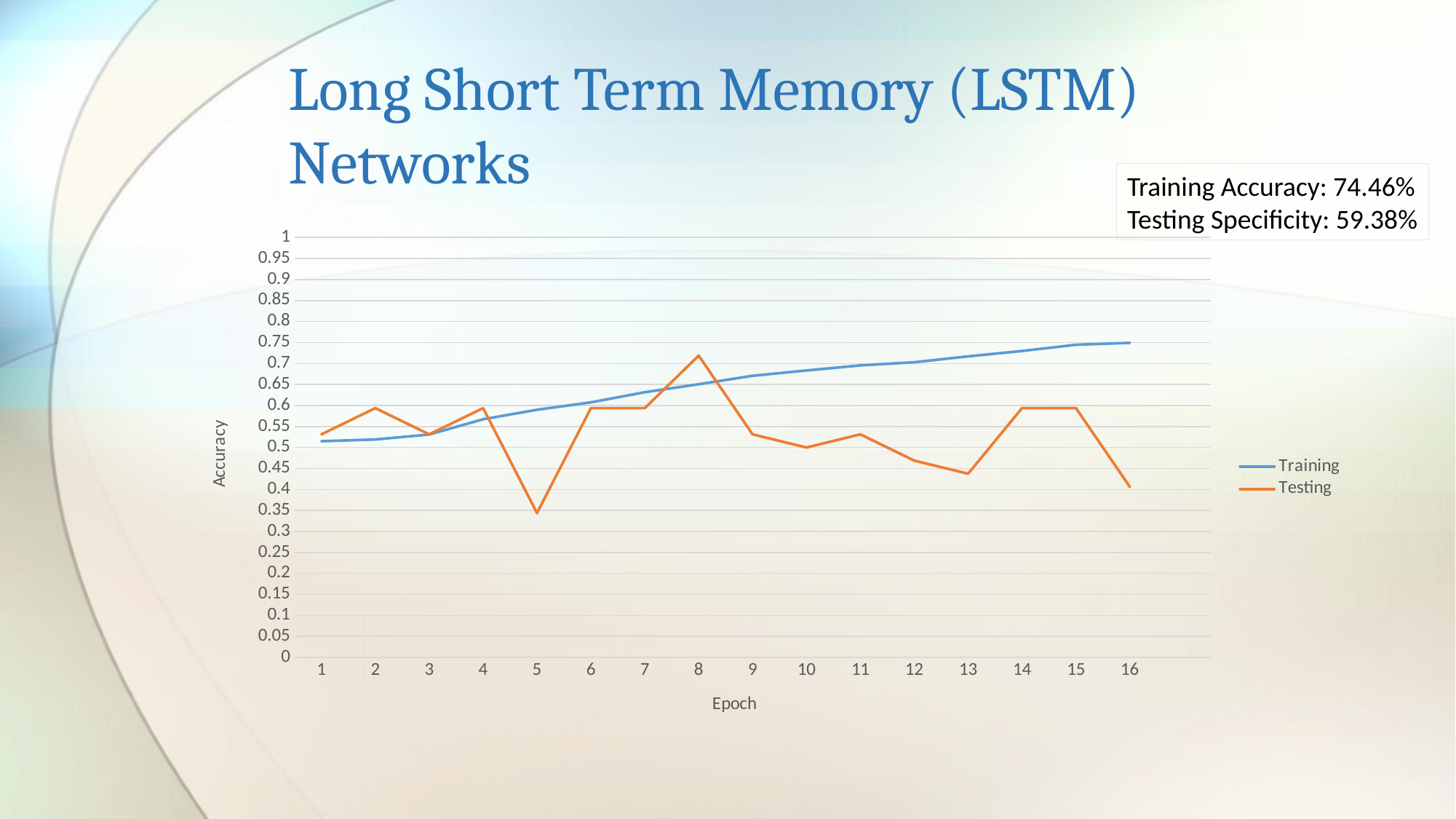
Is the Testing value at epoch 5 greater or less than 0.4? less Is the Testing value at epoch 16 greater or less than 0.45? less Does the Training series rise or fall as the epoch increases? rise What kind of chart is shown on the slide? line chart How many series does the legend list? 2 At which epoch is the Testing series lowest? 5 At which epoch is the Testing series highest? 8 At epoch 8, which series has the higher value, Training or Testing? Testing At which epoch is the Training series highest? 16 Is the Training value at epoch 16 greater or less than 0.7? greater How many epochs are plotted along the x axis? 16 What is the label of the y axis? Accuracy